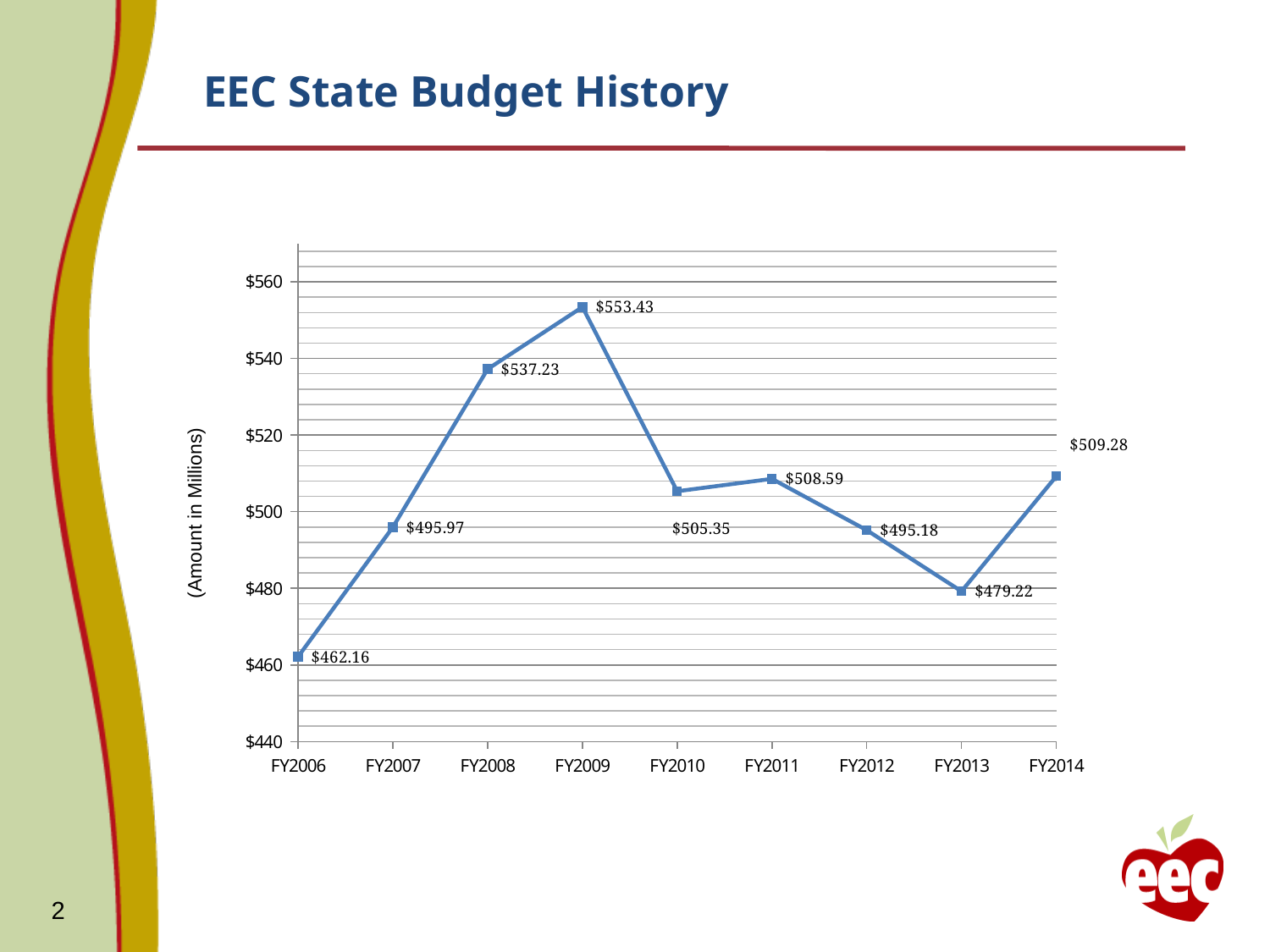
Which fiscal year has the highest value? FY2009 What is the value for FY2006? $462.16 What is the difference between the values for FY2009 and FY2006? $91.27 What is the value for FY2013? $479.22 How many fiscal years are plotted on the chart? 9 Which is larger, the value for FY2010 or the value for FY2012? FY2010 What is the label of the vertical axis? (Amount in Millions) What is the value for FY2009? $553.43 What kind of chart is shown on the slide? Line chart What is the difference between the values for FY2008 and FY2007? $41.26 What is the value for FY2014? $509.28 Which fiscal year has the lowest value? FY2006